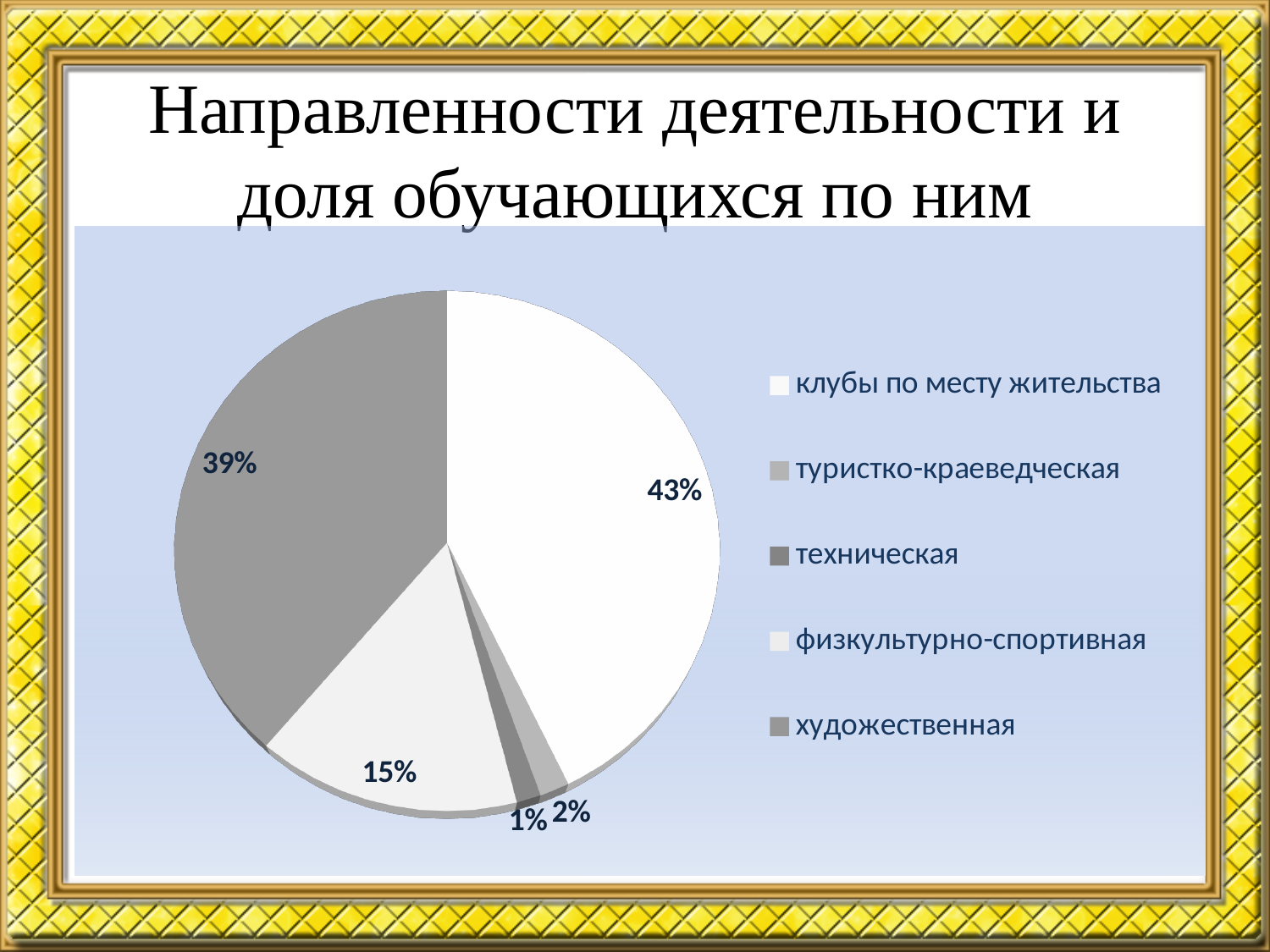
Which is larger: the share for "физкультурно-спортивная" or for "туристко-краеведческая"? физкультурно-спортивная What share of the pie does "туристко-краеведческая" have? 2% What share of the pie does "клубы по месту жительства" have? 43% What kind of chart is shown on the slide? pie chart What is the difference in percentage points between "клубы по месту жительства" and "художественная"? 4% How many categories does the pie chart have? 5 Which category has the smallest slice of the pie? техническая What is the title of the slide containing the chart? Направленности деятельности и доля обучающихся по ним What share of the pie does "техническая" have? 1% Which category has the largest slice of the pie? клубы по месту жительства